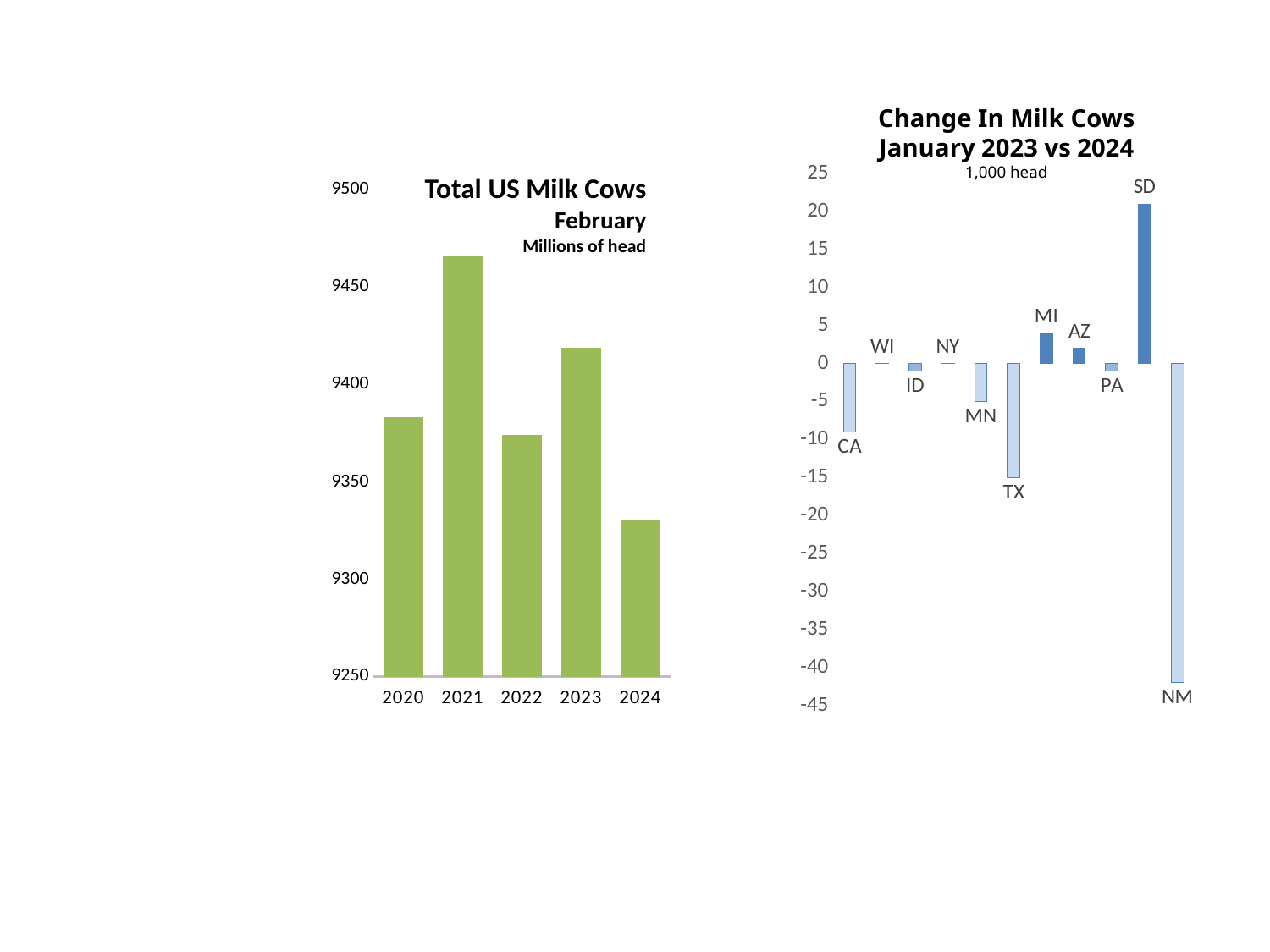
On the Change In Milk Cows chart, is the value for NM greater or less than -40? less What kind of chart is the Change In Milk Cows chart? bar chart On the Total US Milk Cows chart, which year has the lowest value? 2024 On the Change In Milk Cows chart, which state has the lowest value? NM On the Total US Milk Cows chart, how many years are plotted? 5 On the Total US Milk Cows chart, does the value rise or fall from 2023 to 2024? fall On the Change In Milk Cows chart, is the value for TX greater or less than -10? less On the Total US Milk Cows chart, which is larger, the value for 2021 or the value for 2023? 2021 On the Total US Milk Cows chart, which year has the highest value? 2021 On the Total US Milk Cows chart, is the value for 2024 greater or less than 9350? less On the Change In Milk Cows chart, which state has the highest value? SD